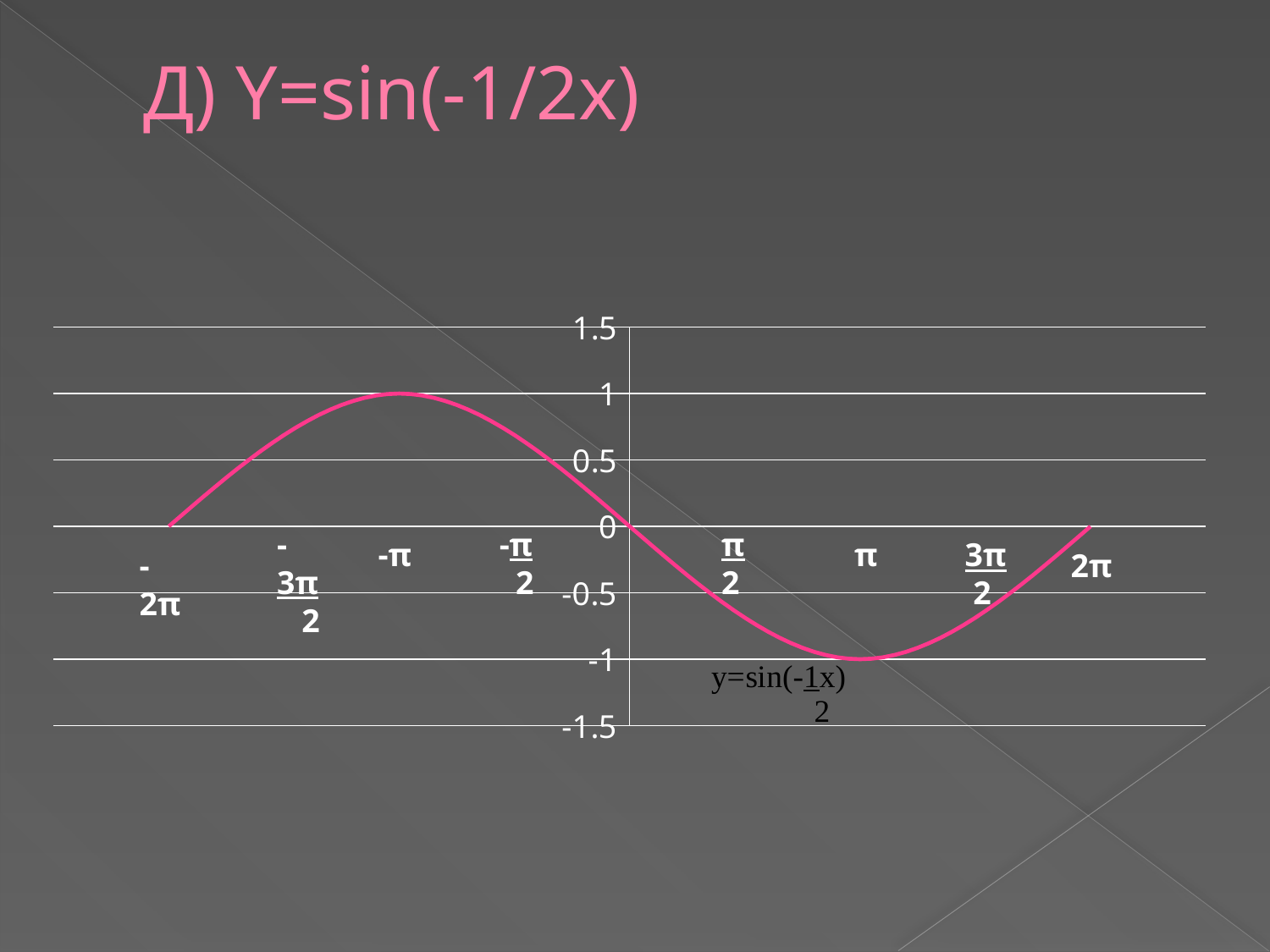
What kind of chart is shown on the slide? line chart What is the value of the curve at x = 2π? 0 What is the value of the curve at x = 0? 0 What is the value of the curve at x = -π? 1 How many labelled x-axis values are shown on the chart? 8 Is the value of the curve at x = -π/2 greater or less than 0.5? greater What is the value of the curve at x = π? -1 At which labelled x value does the curve reach its lowest point? π At which labelled x value does the curve reach its highest point? -π Does the curve rise or fall as x goes from 0 to π? fall Is the value of the curve at x = π/2 greater or less than -0.5? less What colour is the plotted curve? pink